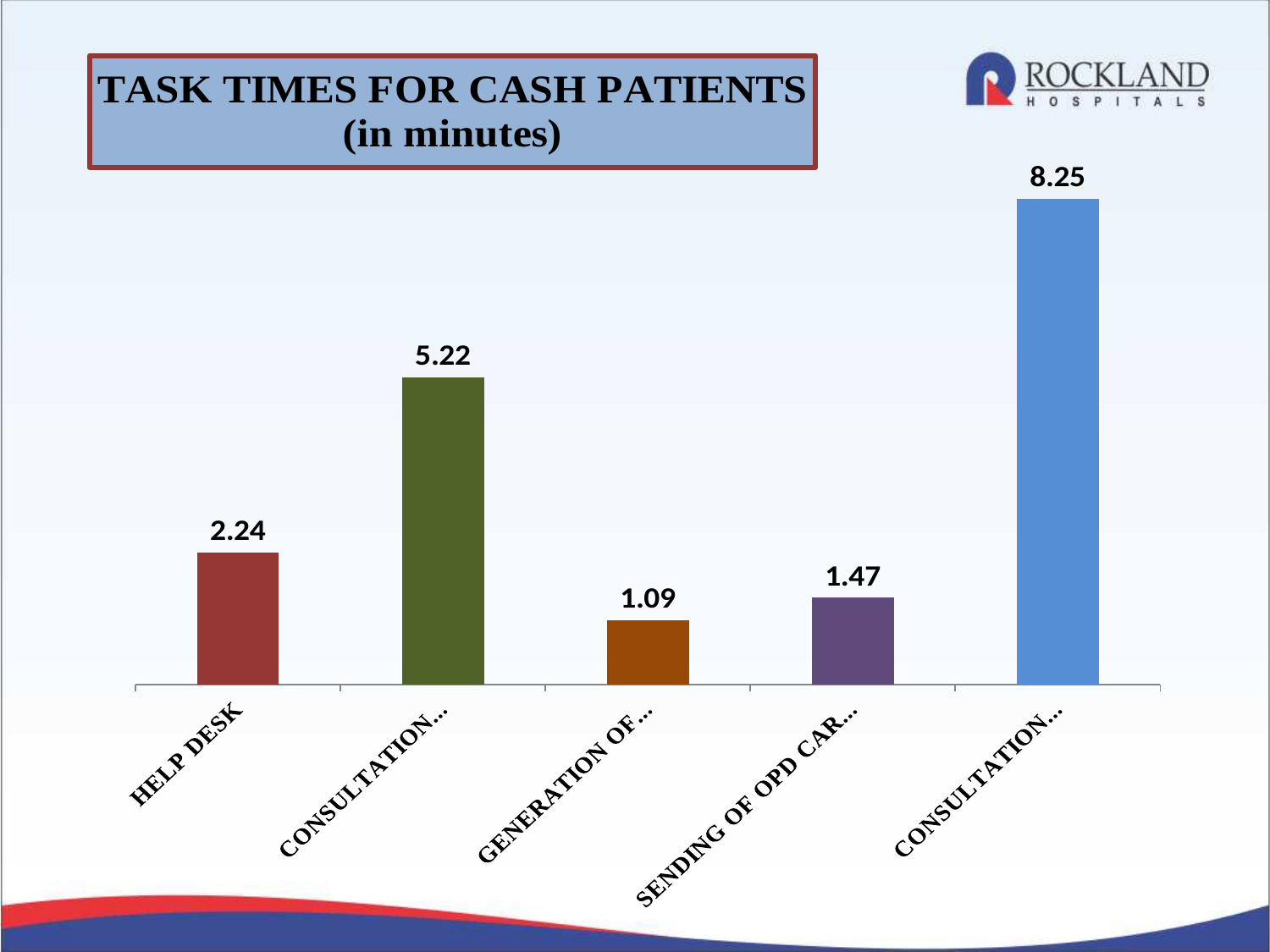
What is the difference between the rightmost bar's value (8.25) and the HELP DESK value? 6.01 What is the task time for the bar labelled GENERATION OF...? 1.09 How many bars are shown in the chart? 5 Which is larger, the task time for HELP DESK or for SENDING OF OPD CAR...? HELP DESK Which bar has the lowest task time? GENERATION OF... What is the value shown on the second bar from the left (labelled CONSULTATION...)? 5.22 Which bar has the highest task time? The rightmost bar (CONSULTATION...) How much larger is the SENDING OF OPD CAR... value than the GENERATION OF... value? 0.38 What is the task time for HELP DESK? 2.24 What type of chart is shown on the slide? Bar chart What is the task time for the bar labelled SENDING OF OPD CAR...? 1.47 What is the value shown on the rightmost bar (labelled CONSULTATION...)? 8.25